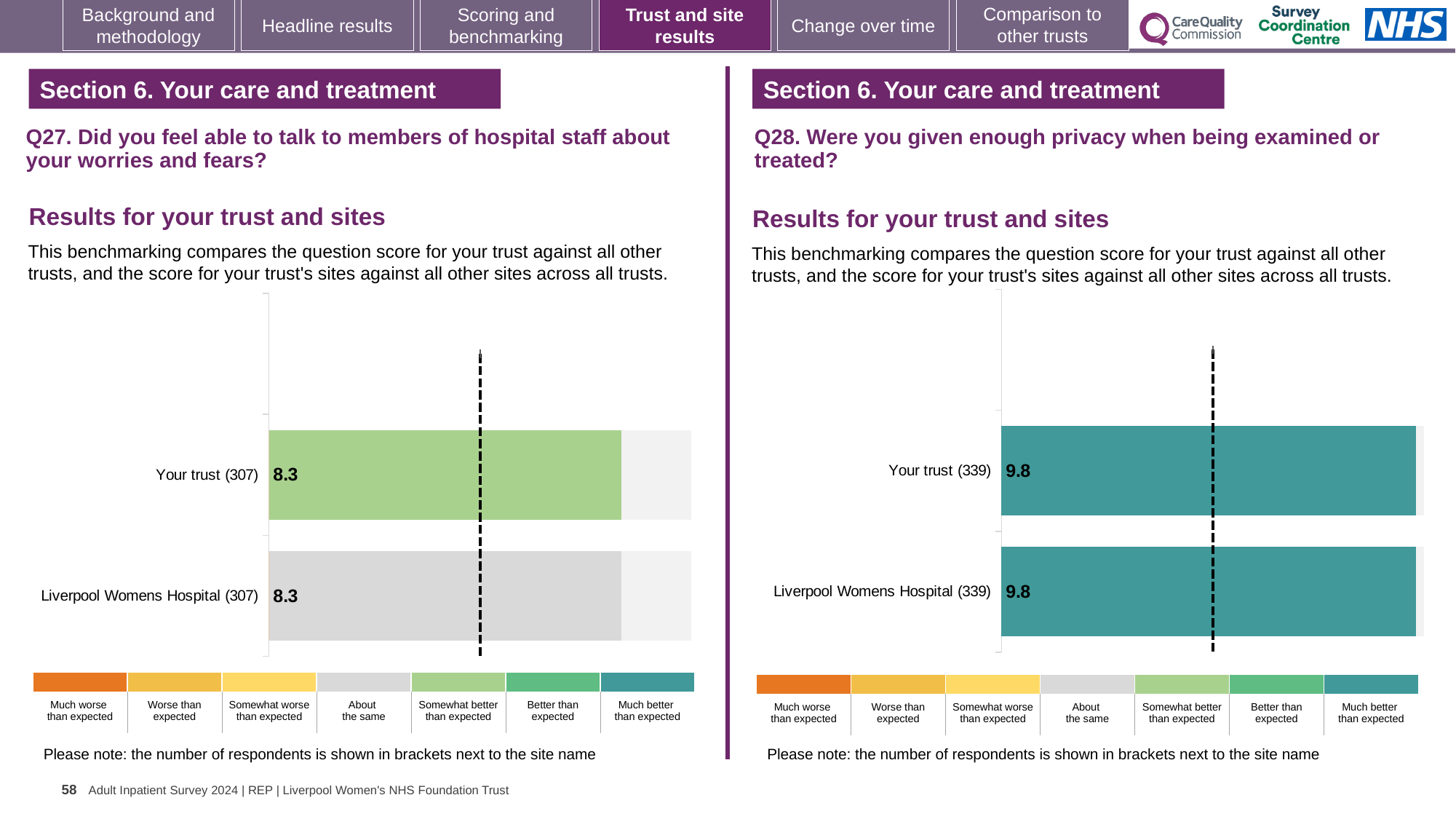
How many bars are plotted on the Q28 chart (right)? 2 On the Q27 chart (left), what is the score for Liverpool Womens Hospital (307)? 8.3 On the Q28 chart (right), what is the score for Your trust (339)? 9.8 On the Q27 chart (left), how many respondents are shown in brackets for Your trust? 307 On the Q27 chart (left), which benchmark category does the colour of the Liverpool Womens Hospital (307) bar correspond to? About the same On the Q27 chart (left), what is the difference between the score for Your trust and the score for Liverpool Womens Hospital? 0 What type of chart is used for the Q27 results (left)? Bar chart On the Q28 chart (right), what is the score for Liverpool Womens Hospital (339)? 9.8 How many bars are plotted on the Q27 chart (left)? 2 On the Q28 chart (right), what is the difference between the score for Your trust and the score for Liverpool Womens Hospital? 0 On the Q28 chart (right), which benchmark category does the colour of the Your trust (339) bar correspond to? Much better than expected On the Q27 chart (left), what is the score for Your trust (307)? 8.3